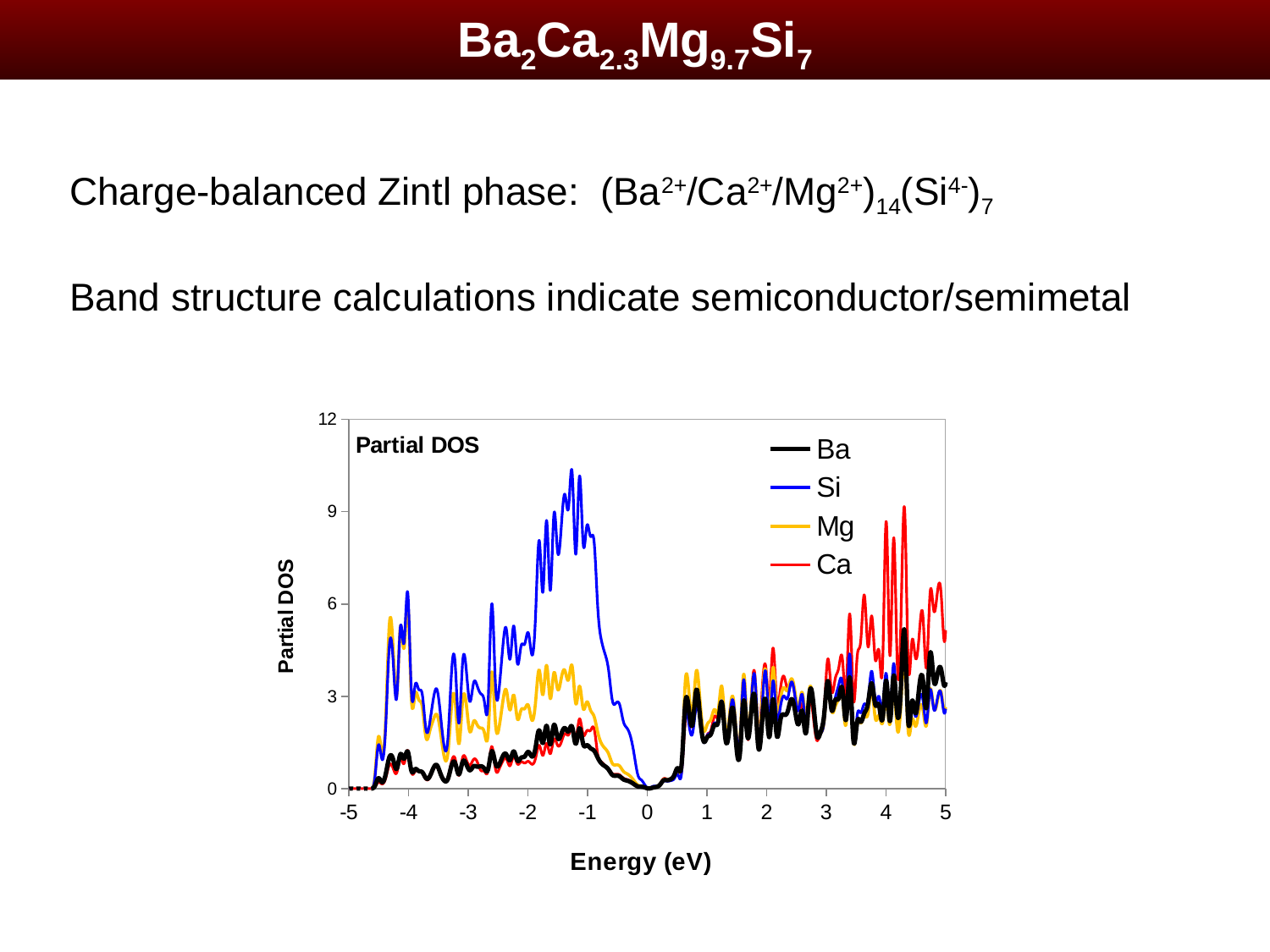
Which series has the highest partial DOS between 3 eV and 5 eV? Ca How many series does the legend of the Partial DOS chart list? 4 Is the highest peak of the Ca series between 4 and 5 eV greater or less than 6? greater What is the label of the x axis of the Partial DOS chart? Energy (eV) Is the peak value of the Si series near -1 eV greater or less than 9? greater Which series reaches the highest partial DOS value anywhere on the chart? Si At -1 eV, which series has the larger partial DOS, Si or Ba? Si Is the value of the Ba series at 0 eV greater or less than 3? less Which colour is used for the Si series in the Partial DOS chart? blue What kind of chart is shown on the slide? line chart